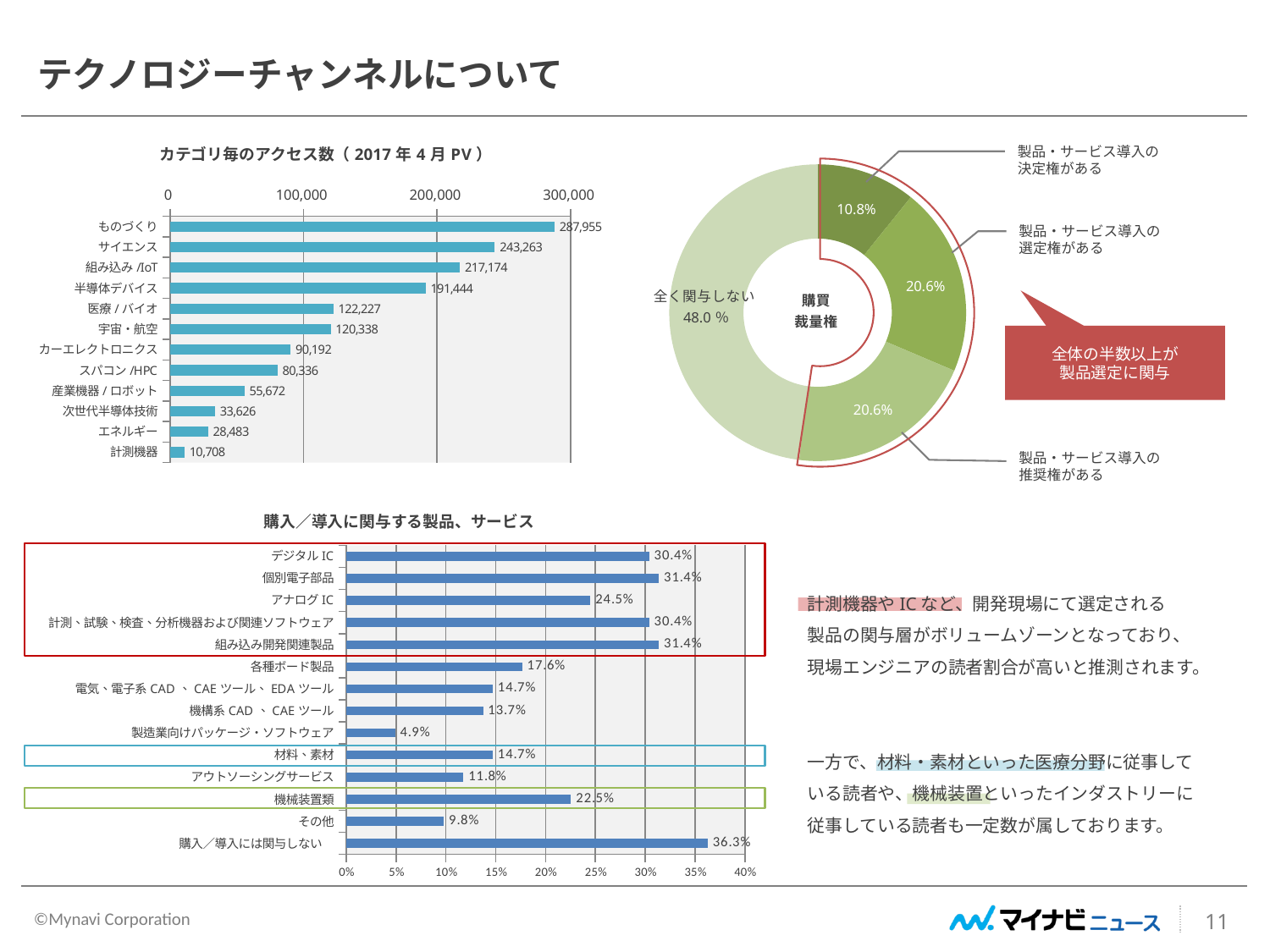
In the chart 'カテゴリ毎のアクセス数（2017年4月PV）', which category has the highest value? ものづくり In the chart '購入／導入に関与する製品、サービス', what is the value for 機械装置類? 22.5% In the chart '購入／導入に関与する製品、サービス', which is larger, アナログ IC or 各種ボード製品? アナログ IC In the chart 'カテゴリ毎のアクセス数（2017年4月PV）', which category has the lowest value? 計測機器 In the chart '購入／導入に関与する製品、サービス', how many categories are shown? 14 In the chart 'カテゴリ毎のアクセス数（2017年4月PV）', what kind of chart is it? Bar chart In the chart 'カテゴリ毎のアクセス数（2017年4月PV）', what is the difference between ものづくり and サイエンス? 44,692 In the chart '購入／導入に関与する製品、サービス', which category has the highest value? 購入／導入には関与しない In the donut chart '購買裁量権', what share is 全く関与しない? 48.0% In the chart 'カテゴリ毎のアクセス数（2017年4月PV）', how many categories are shown? 12 In the chart 'カテゴリ毎のアクセス数（2017年4月PV）', what is the value for サイエンス? 243,263 In the donut chart '購買裁量権', what share has 製品・サービス導入の決定権がある? 10.8%